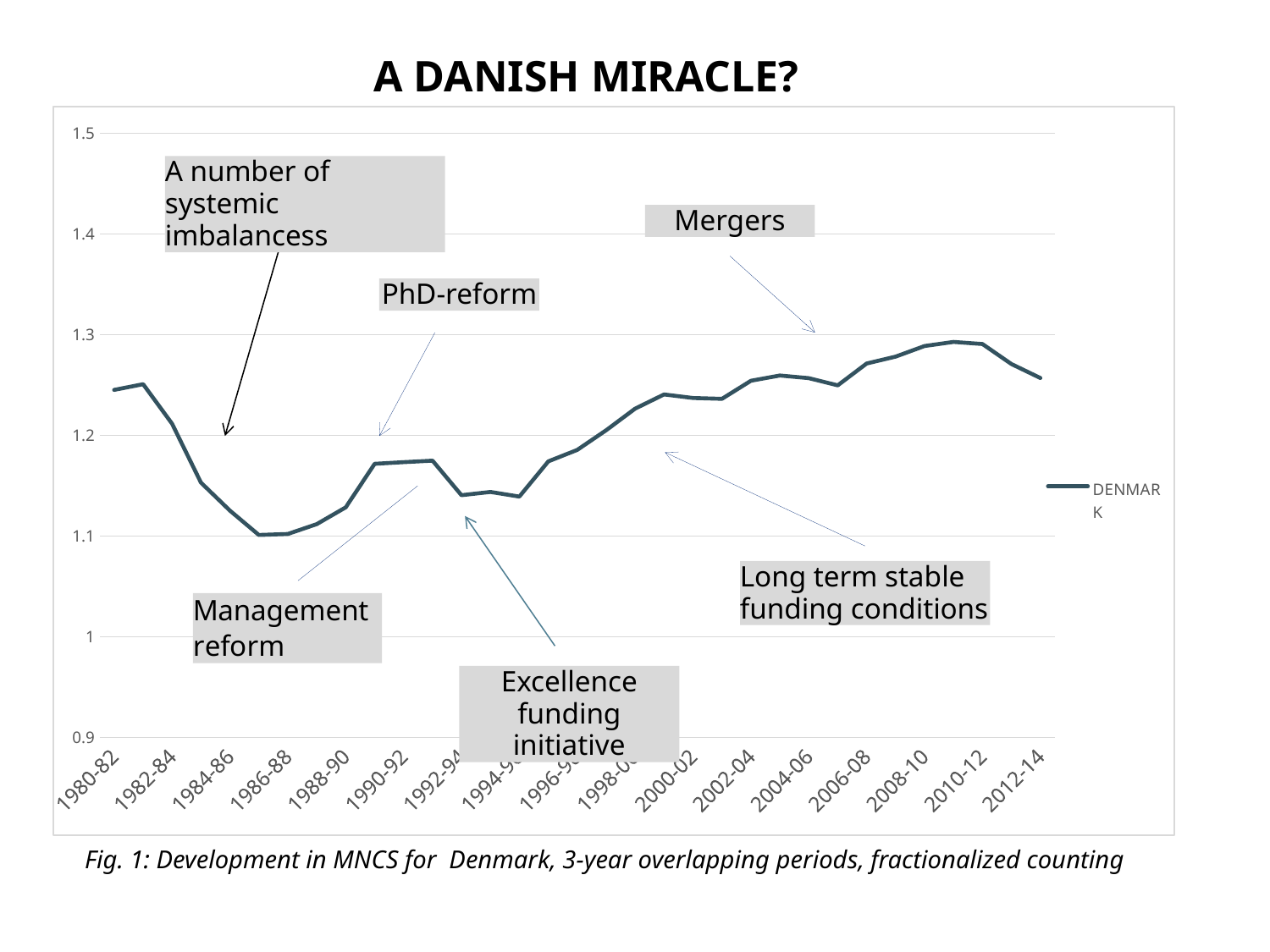
What kind of chart is shown on the slide? line chart Is the value for 1990-92 greater or less than 1.2? less How many series does the legend list? 1 Is the value for 2008-10 greater or less than 1.3? less Is the value for 1984-86 greater or less than 1.2? less What is the name of the series shown in the legend? DENMARK Do the values rise or fall from 1980-82 to 1986-88? fall Which period has the larger value, 1986-88 or 2008-10? 2008-10 Which period has the larger value, 1980-82 or 1990-92? 1980-82 What is the title of the slide containing the chart? A DANISH MIRACLE?